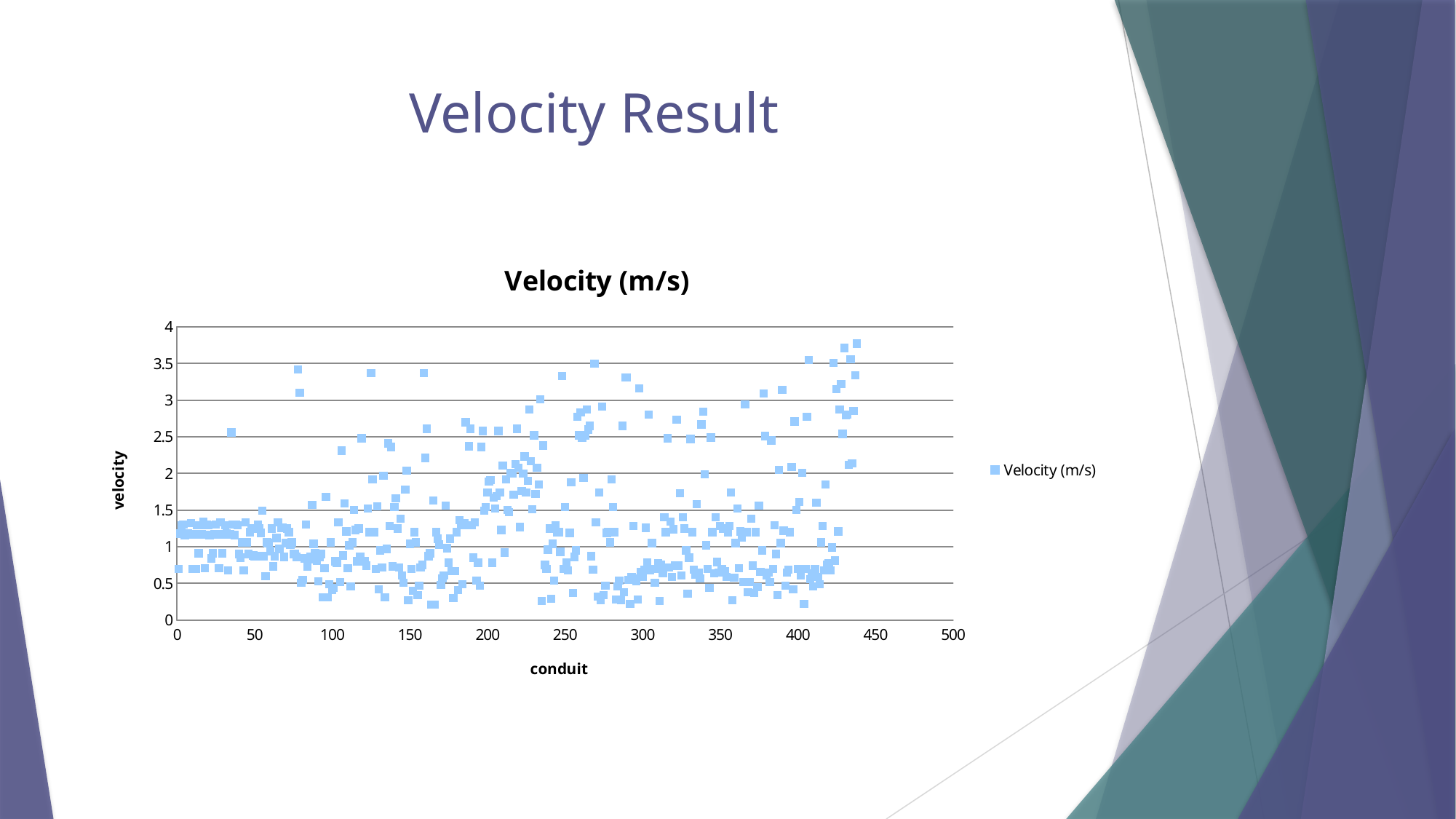
How many series does the chart legend list? 1 What kind of chart is shown on the slide? scatter chart What is the label on the x axis of the chart? conduit What is the title of the chart? Velocity (m/s) What is the maximum value shown on the y axis of the chart? 4 Is the highest plotted velocity value greater or less than 3.5? greater Are there any plotted points beyond conduit 450 on the x axis? No Is the lowest plotted velocity value greater or less than 0.5? less What is the maximum value shown on the x axis of the chart? 500 Is the highest plotted velocity value greater or less than 4? less